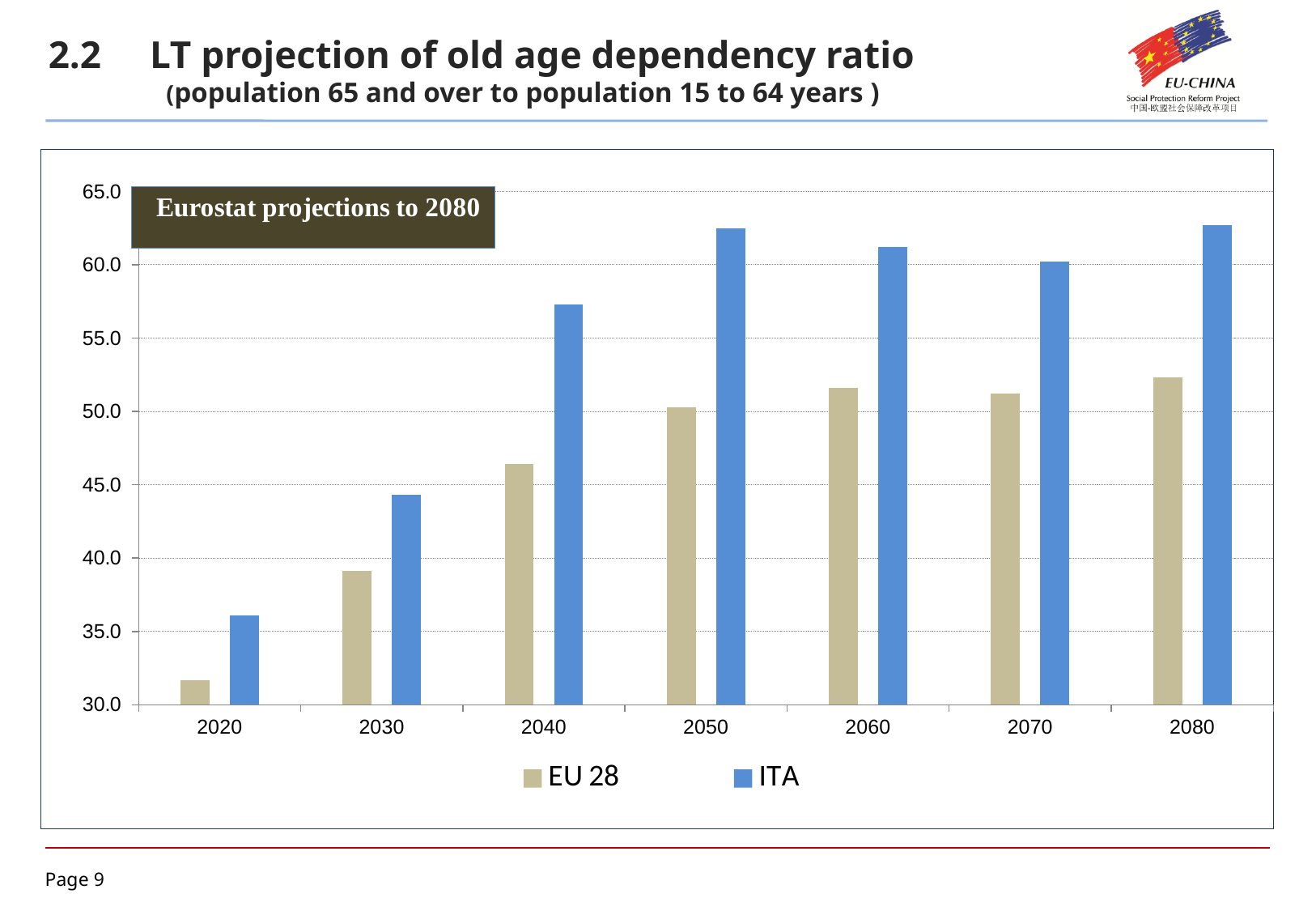
What kind of chart is shown on the slide? Bar chart Is the value for ITA in 2040 greater or less than 55.0? greater Does the EU 28 series generally rise or fall from 2020 to 2080? rise Is the value for EU 28 in 2030 greater or less than 40.0? less Which year has the lowest value for ITA? 2020 How many series does the legend list? 2 Is the value for EU 28 in 2020 greater or less than 35.0? less Which is larger: the ITA value in 2050 or the ITA value in 2070? 2050 What does the text box inside the chart say? Eurostat projections to 2080 How many years are shown along the x axis? 7 Which year has the lowest value for EU 28? 2020